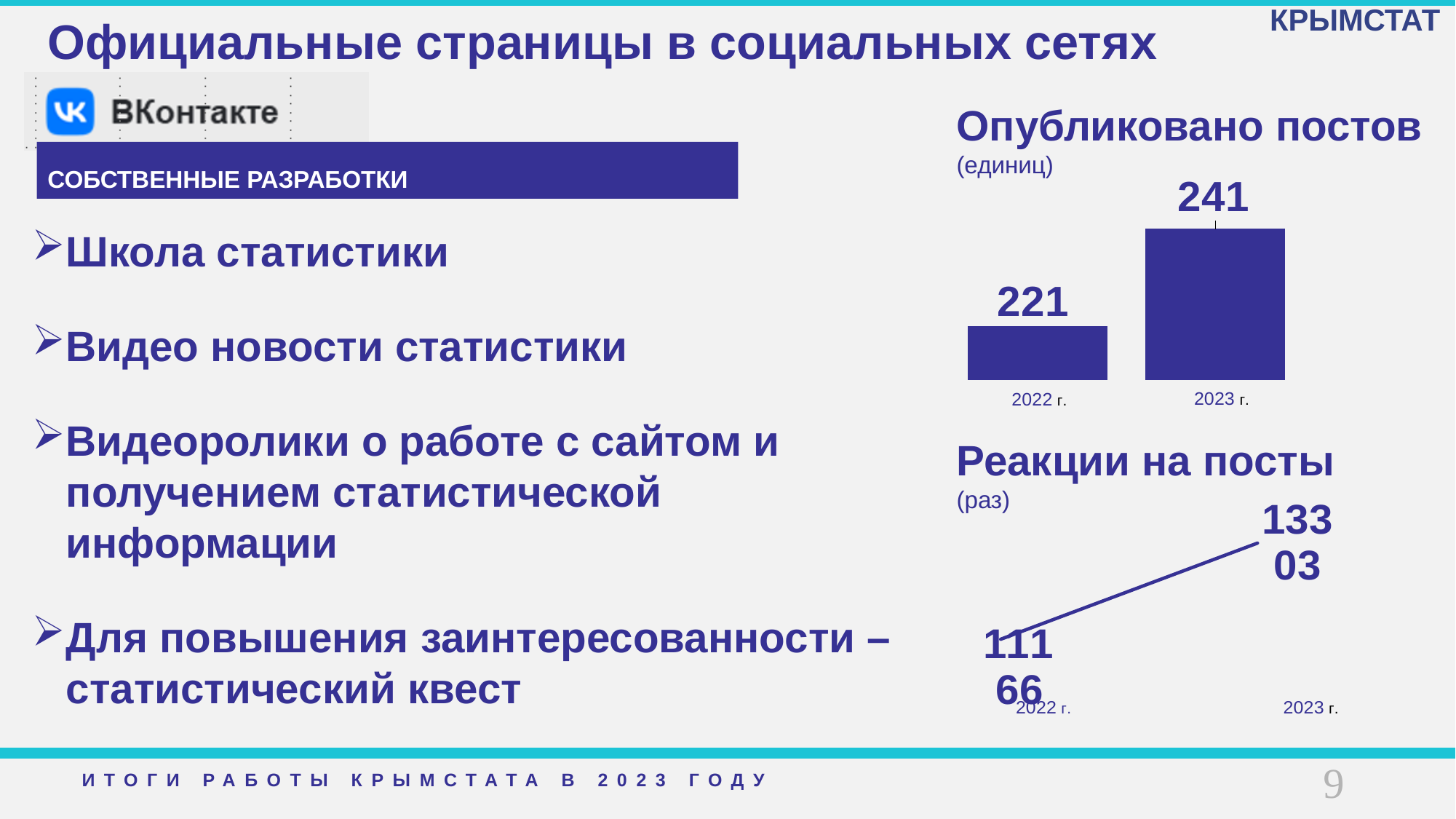
In the 'Опубликовано постов' chart, which year has the lower value? 2022 г. In the 'Реакции на посты' chart, what is the value for 2023 г.? 13303 In the 'Опубликовано постов' chart, what is the value for 2023 г.? 241 In the 'Реакции на посты' chart, is the value for 2023 г. larger or smaller than the value for 2022 г.? larger What type of chart is the 'Опубликовано постов' chart? bar chart In the 'Опубликовано постов' chart, what is the value for 2022 г.? 221 In the 'Опубликовано постов' chart, what is the difference between the 2023 г. and 2022 г. values? 20 In the 'Реакции на посты' chart, what is the value for 2022 г.? 11166 In the 'Опубликовано постов' chart, how many categories are shown? 2 What type of chart is the 'Реакции на посты' chart? line chart In the 'Опубликовано постов' chart, which year has the higher value? 2023 г. In the 'Опубликовано постов' chart, do the values rise or fall from 2022 г. to 2023 г.? rise